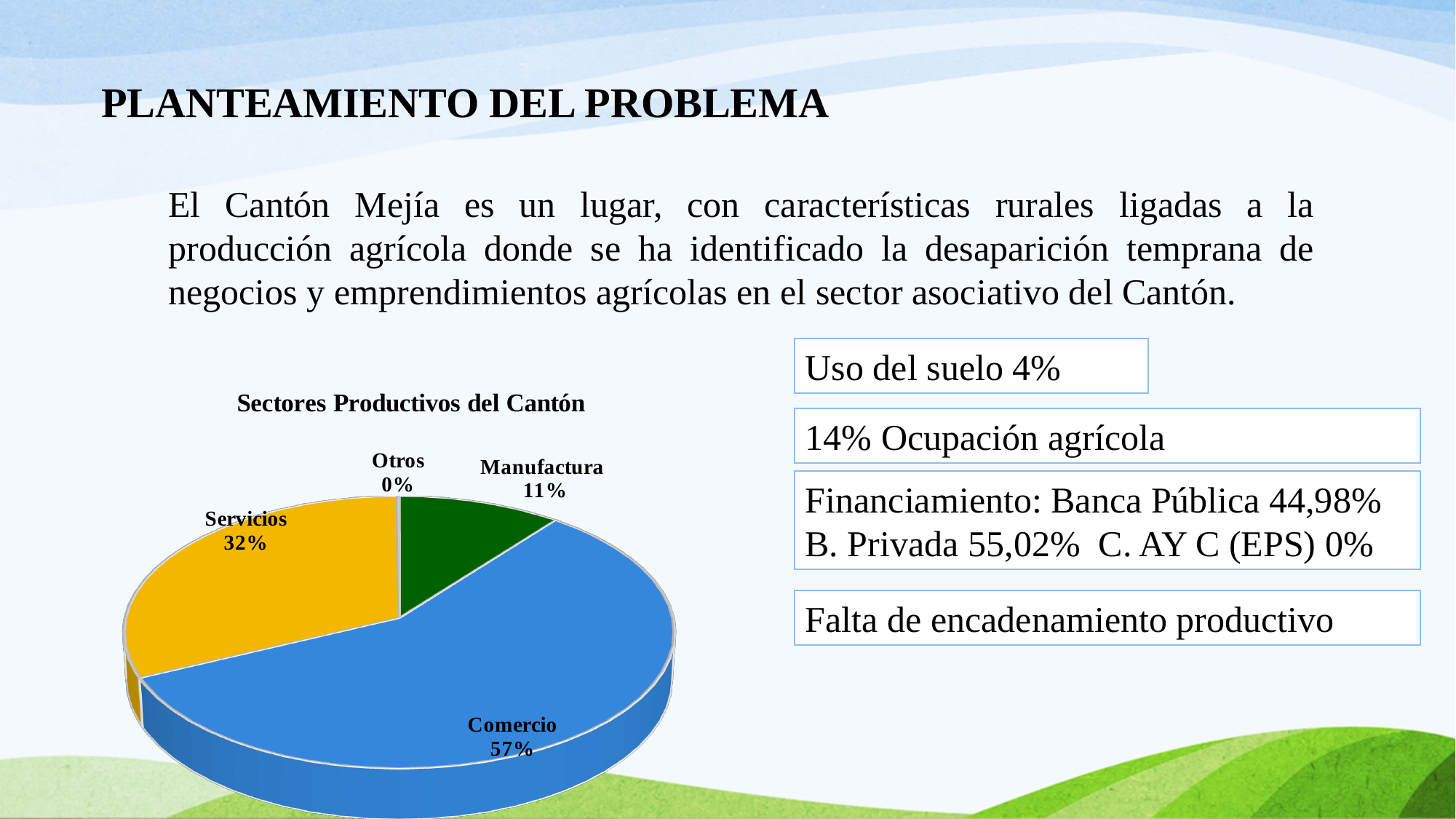
Which sector has the smallest share in the chart? Otros How many sectors are shown in the pie chart? 4 What percentage does Otros represent in the chart? 0% What type of chart is shown on the slide? Pie chart Which sector has the largest share in the chart? Comercio What is the difference in percentage points between Comercio and Servicios? 25 What percentage does Manufactura represent in the chart? 11% What is the title of the chart? Sectores Productivos del Cantón What colour is the Comercio slice? Blue What percentage does Comercio represent in the chart? 57% What percentage does Servicios represent in the chart? 32% Which is larger, Servicios or Manufactura? Servicios